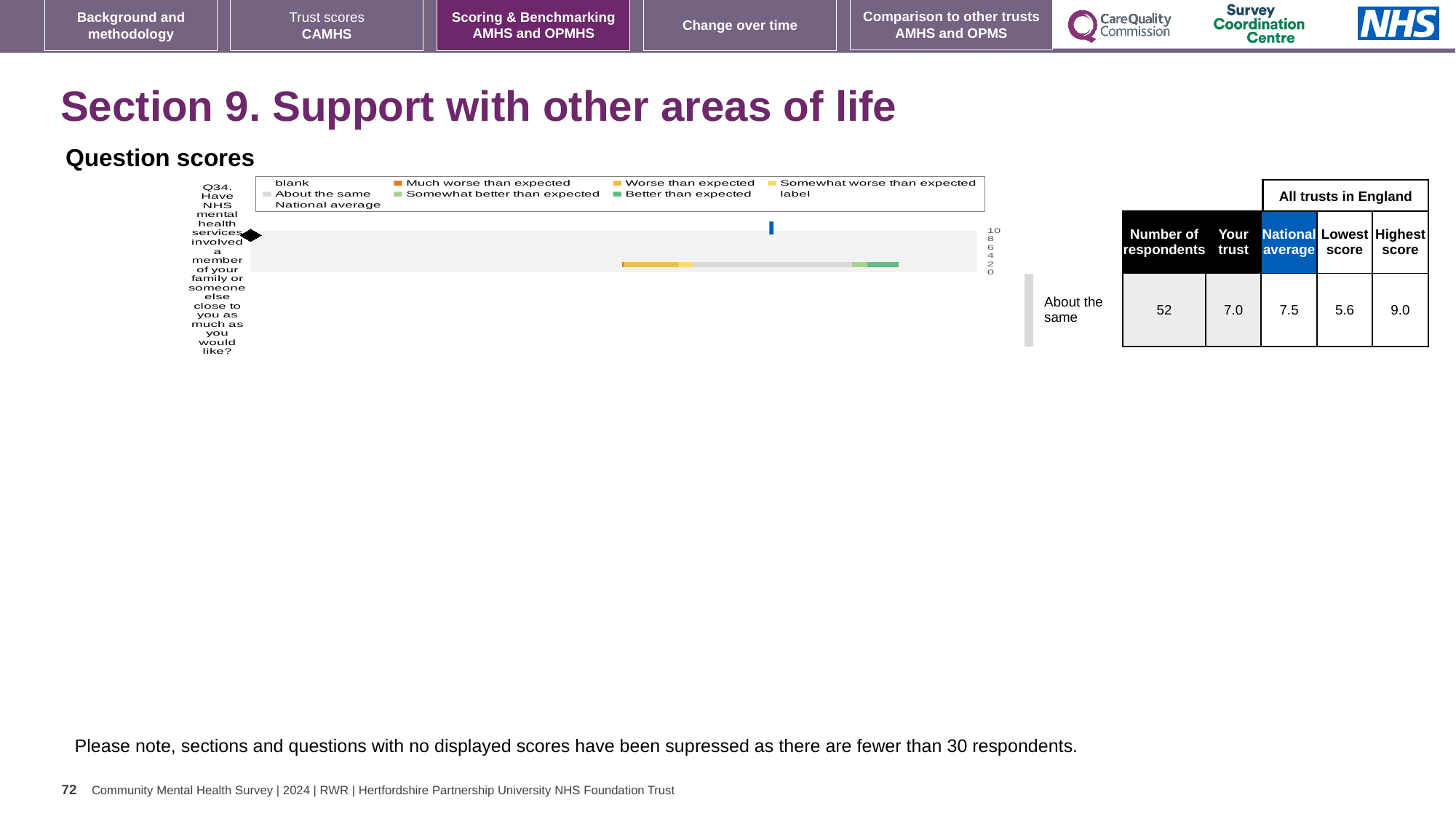
In the table beside the chart, what is the national average for Q34? 7.5 Which is larger for Q34, the 'Your trust' score or the national average? National average In the table beside the chart, what is the 'Your trust' score for Q34? 7.0 How many questions (categories) are plotted in the Question scores chart? 1 In the table beside the chart, what is the number of respondents for Q34? 52 What benchmark category is the trust's Q34 score labelled as next to the chart? About the same In the table beside the chart, what is the lowest score among all trusts in England for Q34? 5.6 In the table beside the chart, what is the highest score among all trusts in England for Q34? 9.0 What is the highest value shown on the axis of the Question scores chart? 10 What is the difference between the highest score and the lowest score for Q34 in the table beside the chart? 3.4 What kind of chart is shown under 'Question scores'? bar chart Which question is plotted in the Question scores chart? Q34. Have NHS mental health services involved a member of your family or someone else close to you as much as you would like?